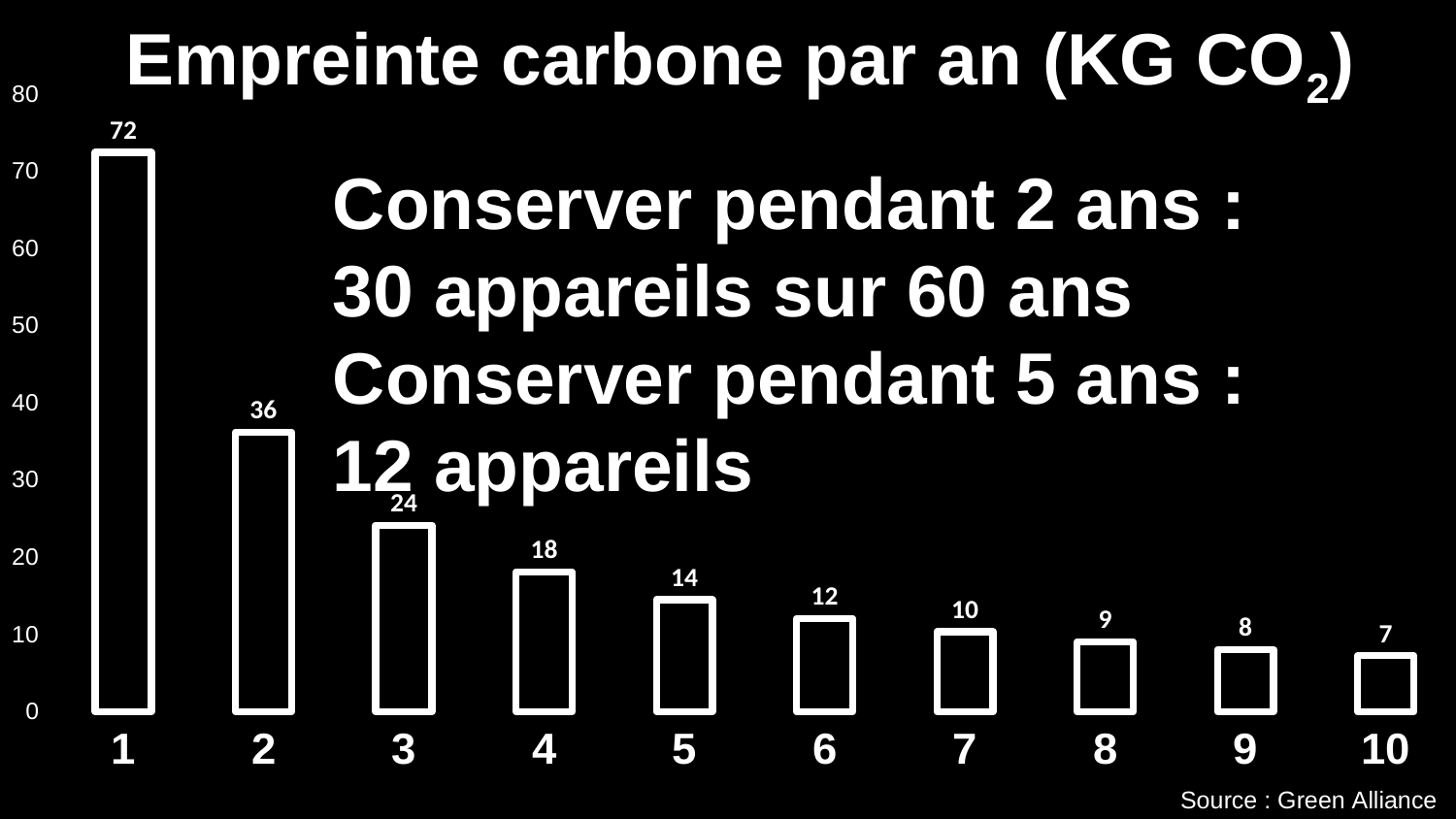
What is the title of the chart? Empreinte carbone par an (KG CO2) How many categories are shown on the x axis? 10 What is the difference between the values for category 1 and category 2? 36 Which category has the lowest value? 10 What kind of chart is this? bar chart What is the value for category 5? 14 Do the values rise or fall from category 1 to category 10? fall What is the value for category 1? 72 Which category has the highest value? 1 What is the difference between the values for category 3 and category 4? 6 Which is larger, the value for category 6 or the value for category 8? category 6 What is the value for category 10? 7